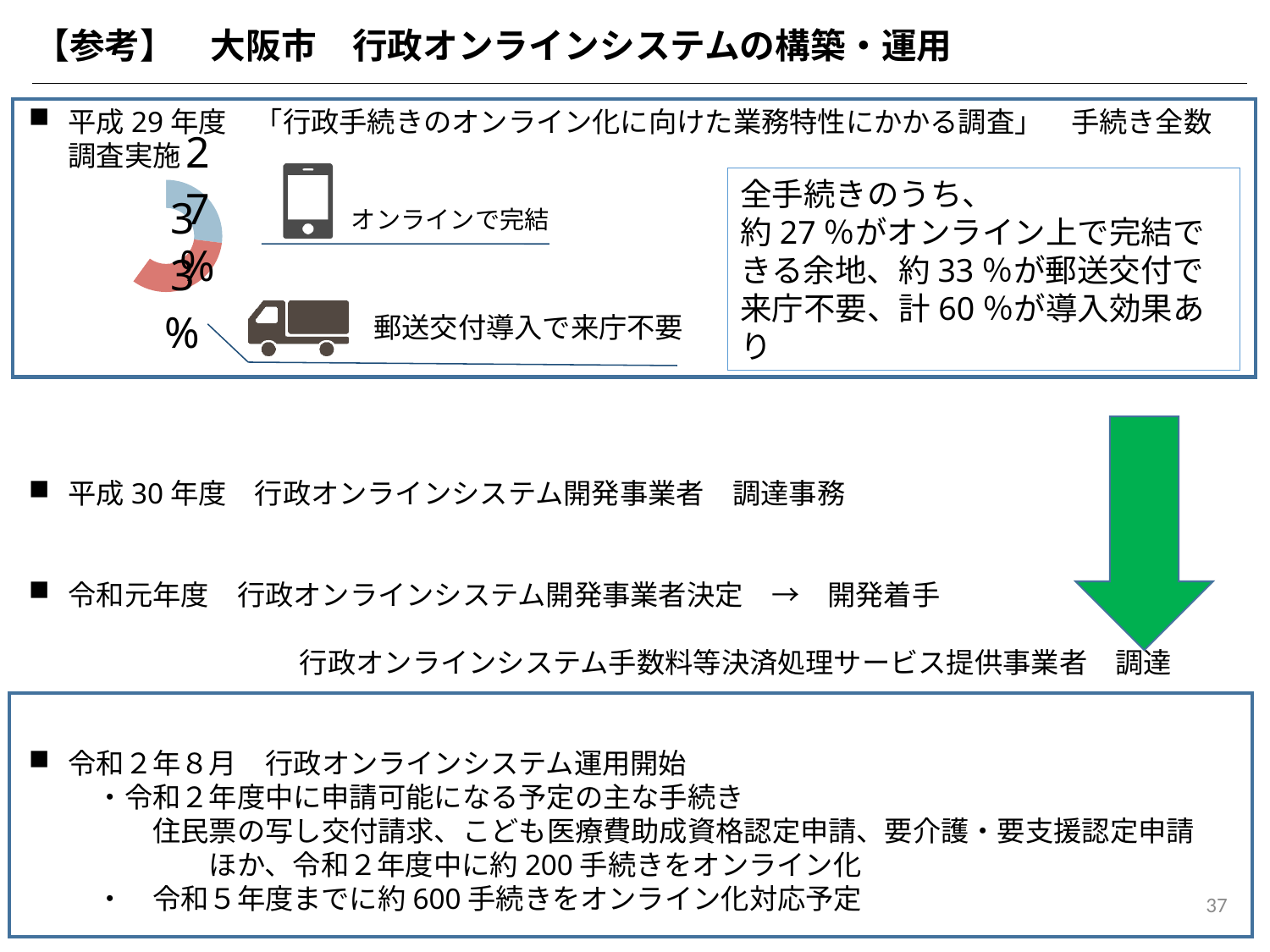
Which category of the doughnut chart is shown with the smartphone icon? オンラインで完結 Which category of the doughnut chart is shown with the truck icon? 郵送交付導入で来庁不要 What kind of chart is shown in the top box of the slide? Doughnut (pie) chart Which slice of the doughnut chart is larger: オンラインで完結 or 郵送交付導入で来庁不要? 郵送交付導入で来庁不要